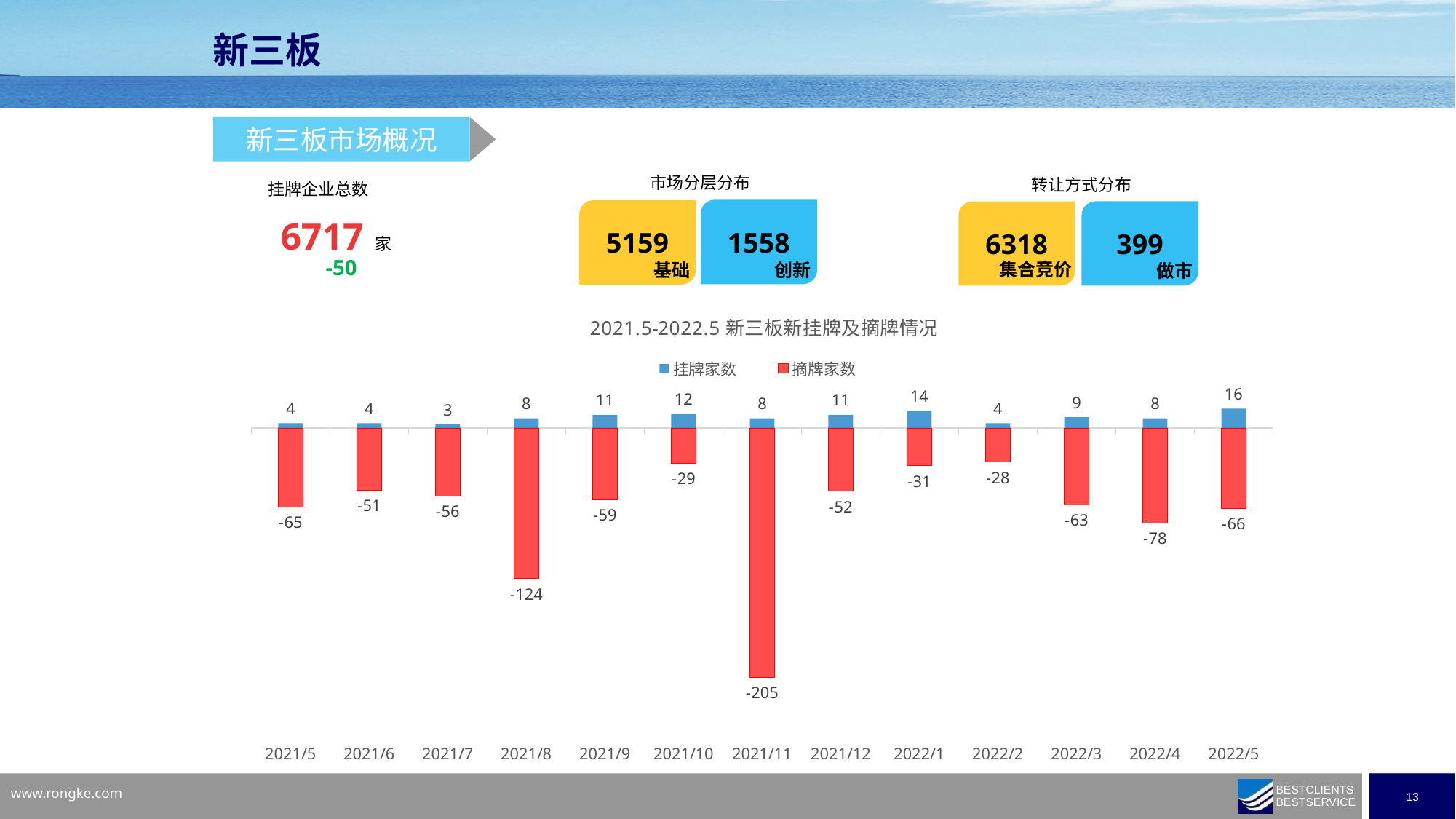
What type of chart is shown under the title 2021.5-2022.5 新三板新挂牌及摘牌情况? bar chart Which month has the largest number of 摘牌家数 (the most negative value)? 2021/11 What is the value of 摘牌家数 for 2021/8? -124 Which month has the lowest 挂牌家数? 2021/7 What is the value of 摘牌家数 for 2021/11? -205 Which is larger in magnitude, the 摘牌家数 for 2021/5 or for 2021/6? 2021/5 How many series does the legend of the chart list? 2 Which month has the highest 挂牌家数? 2022/5 Which colour represents 摘牌家数 in the chart? red What is the difference between the 挂牌家数 for 2022/1 and 2022/2? 10 How many months are shown on the x axis of the chart? 13 What is the value of 挂牌家数 for 2022/5? 16